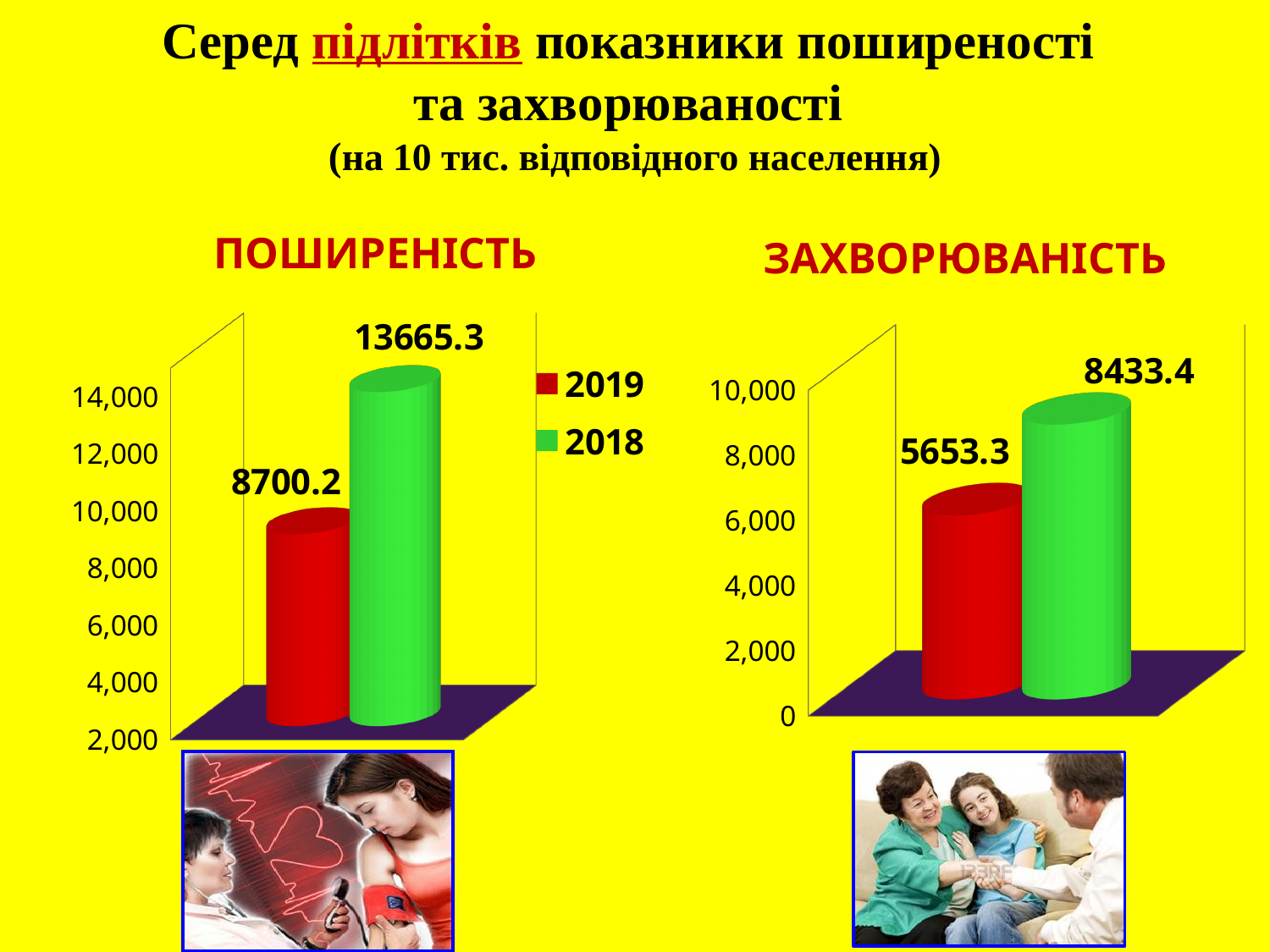
In the ПОШИРЕНІСТЬ chart, what is the value for 2018? 13665.3 In the ЗАХВОРЮВАНІСТЬ chart, what is the value for 2018? 8433.4 In the ПОШИРЕНІСТЬ chart, what is the difference between the 2018 and 2019 values? 4965.1 In the ПОШИРЕНІСТЬ chart, what is the value for 2019? 8700.2 How many series does the legend on the ПОШИРЕНІСТЬ chart list? 2 What type of chart is the ЗАХВОРЮВАНІСТЬ chart? bar chart In the ЗАХВОРЮВАНІСТЬ chart, which year has the lower value? 2019 In the ЗАХВОРЮВАНІСТЬ chart, what is the value for 2019? 5653.3 In the ПОШИРЕНІСТЬ chart, which colour represents 2019? red In the ЗАХВОРЮВАНІСТЬ chart, is the 2019 value greater or less than 6,000? less In the ЗАХВОРЮВАНІСТЬ chart, what is the difference between the 2018 and 2019 values? 2780.1 In the ПОШИРЕНІСТЬ chart, which year has the higher value? 2018